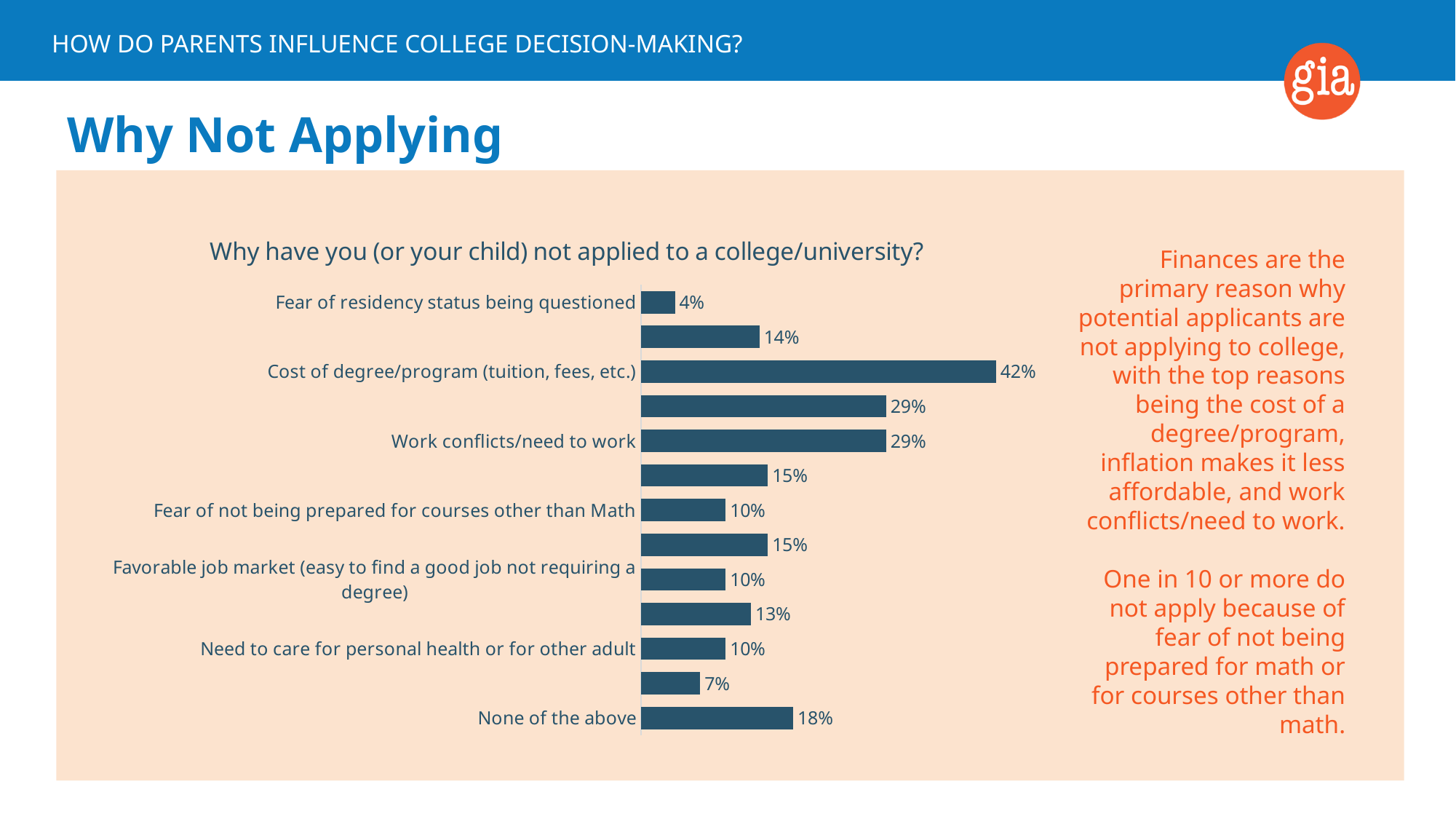
Which is larger: the value for "None of the above" or the value for "Favorable job market (easy to find a good job not requiring a degree)"? None of the above Which reason has the highest percentage in the chart? Cost of degree/program (tuition, fees, etc.) What percentage is shown for "Fear of residency status being questioned"? 4% What percentage is shown for "Need to care for personal health or for other adult"? 10% Which reason has the lowest percentage in the chart? Fear of residency status being questioned What percentage is shown for "Work conflicts/need to work"? 29% How many bars are plotted in the chart? 13 What is the difference in percentage points between "Cost of degree/program (tuition, fees, etc.)" and "Work conflicts/need to work"? 13 percentage points What percentage is shown for "Cost of degree/program (tuition, fees, etc.)"? 42% What percentage is shown for "None of the above"? 18% What type of chart is shown on the slide? Bar chart What is the title of the chart? Why have you (or your child) not applied to a college/university?